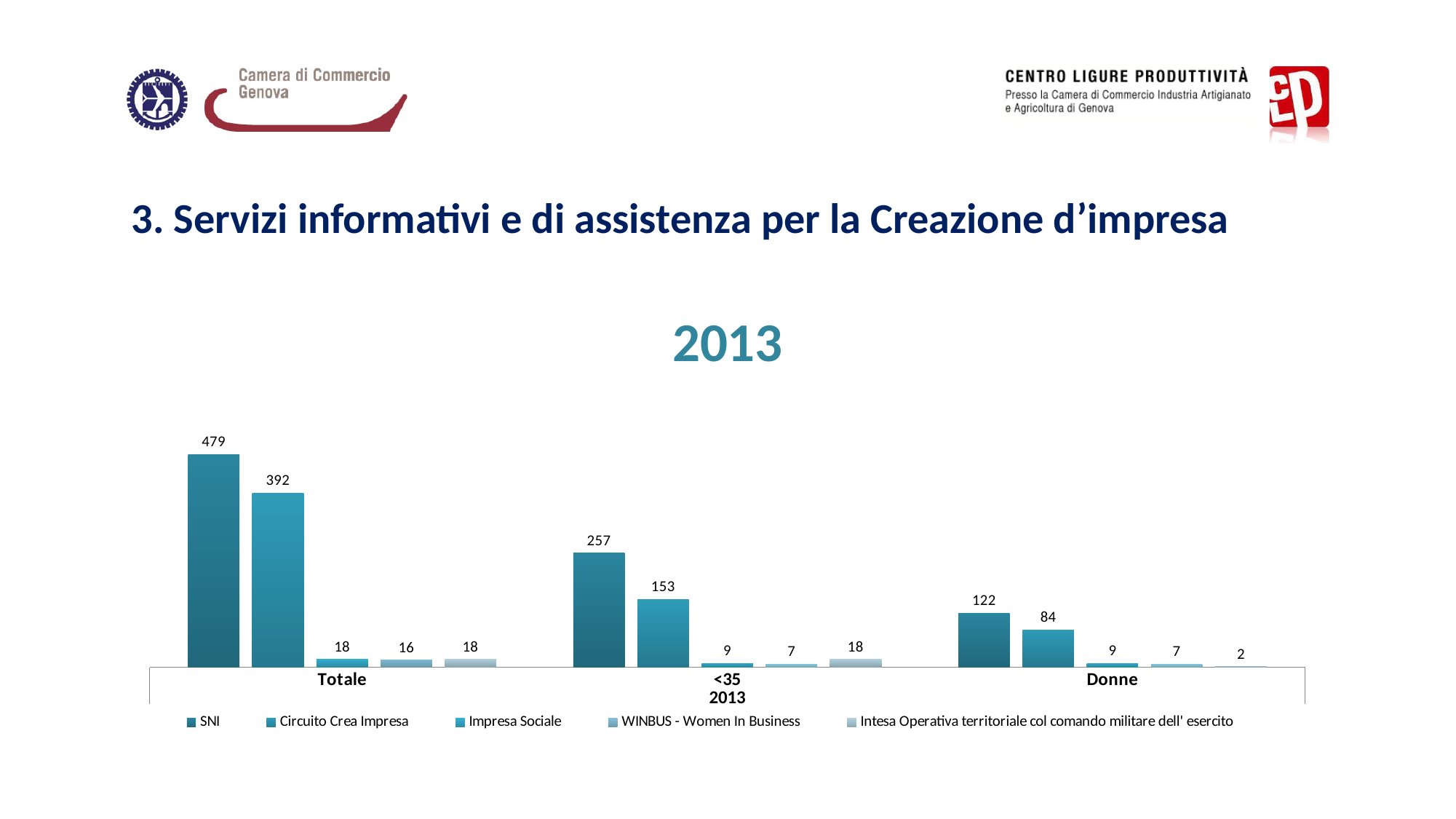
What is the title of the chart? 2013 What kind of chart is shown on the slide? Bar chart What is the value for Circuito Crea Impresa in the <35 category? 153 How many series does the legend list? 5 Which series has the highest value in the Donne category? SNI What is the value for SNI in the Totale category? 479 What is the value for Intesa Operativa territoriale col comando militare dell' esercito in the <35 category? 18 What is the difference between the SNI and Circuito Crea Impresa values in the Totale category? 87 Which is larger: the SNI value for <35 or the SNI value for Donne? SNI value for <35 What is the value for WINBUS - Women In Business in the Donne category? 7 How many categories are shown on the x axis? 3 Which series has the lowest value in the Donne category? Intesa Operativa territoriale col comando militare dell' esercito